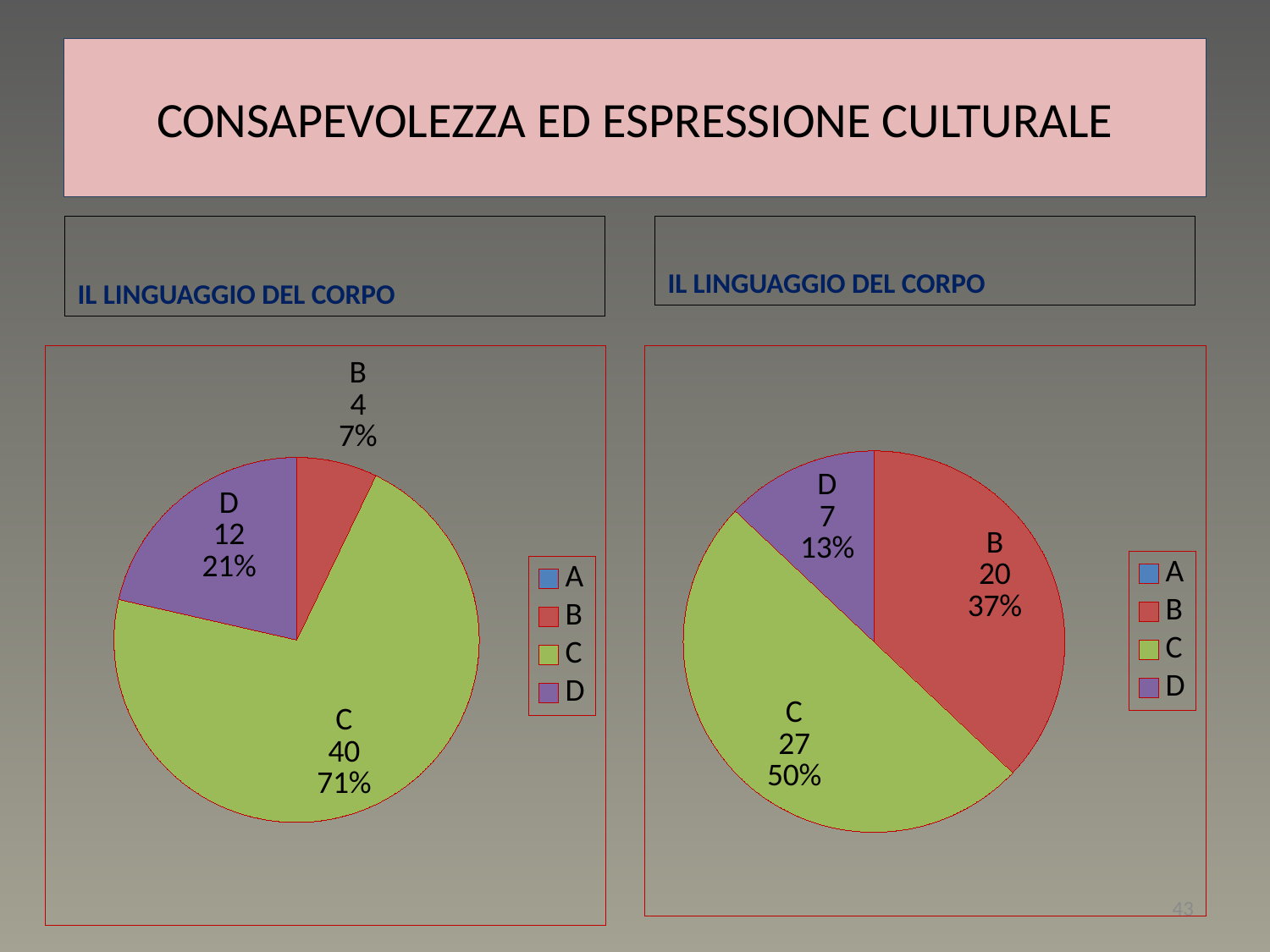
In the left pie chart, which labelled category has the smallest slice? B In the right pie chart, which category has the smallest slice? D In the left pie chart, what is the difference between the values for C and D? 28 In the right pie chart, what percentage share does category C have? 50% In the right pie chart, what is the difference between the values for B and D? 13 What type of chart is shown on the left side of the slide? Pie chart In the left pie chart, which category has the largest slice? C How many entries does the legend of the right pie chart list? 4 In the left pie chart, what value is shown for category C? 40 In the left pie chart, what percentage share does category D have? 21% In the right pie chart, what value is shown for category B? 20 In the right pie chart, which is larger, the value for B or the value for C? C